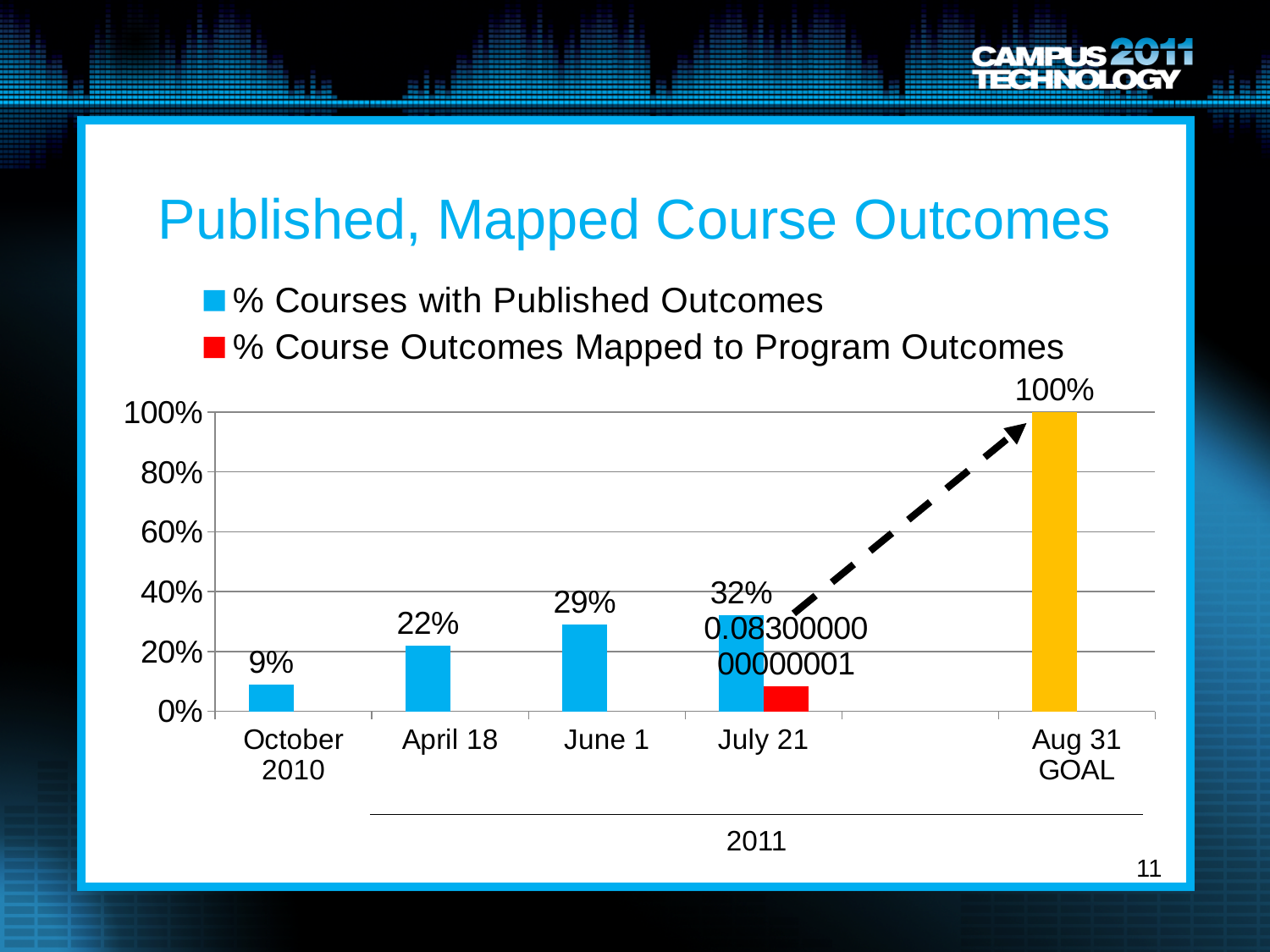
What is the difference between the % Courses with Published Outcomes on July 21 and on April 18? 10% Do the % Courses with Published Outcomes values rise or fall from October 2010 to July 21? rise What type of chart is shown on the slide? bar chart Which is larger: the % Courses with Published Outcomes on June 1 or on April 18? June 1 What is the value for % Courses with Published Outcomes on July 21? 32% What is the value for % Courses with Published Outcomes on April 18? 22% Which category has the lowest value for % Courses with Published Outcomes? October 2010 What is the value for % Courses with Published Outcomes in October 2010? 9% Is the value for % Course Outcomes Mapped to Program Outcomes on July 21 greater or less than 20%? less What is the value for % Courses with Published Outcomes on June 1? 29% What is the value shown for the Aug 31 GOAL bar? 100% How many series does the legend list? 2